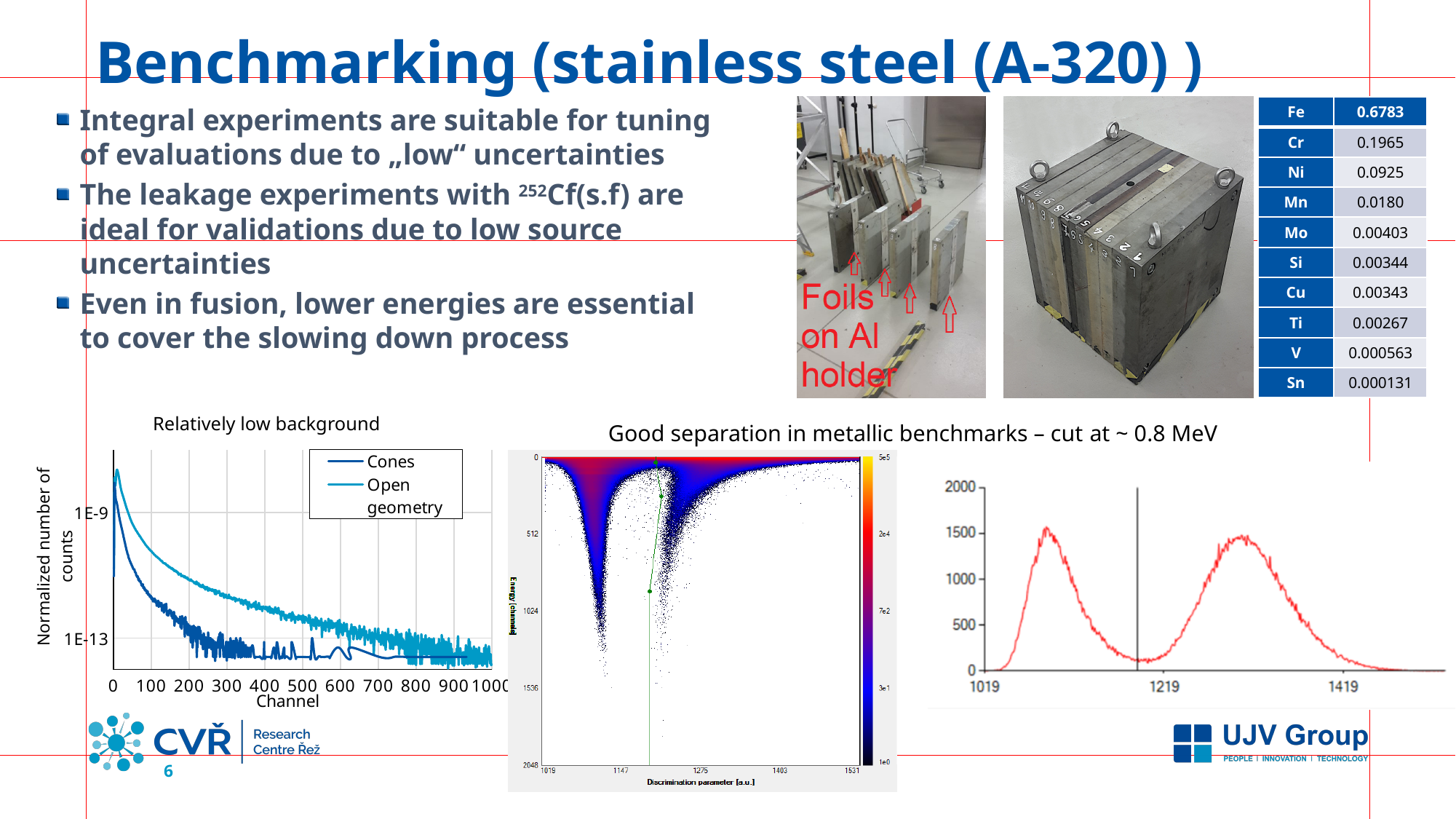
In the 'Relatively low background' chart, is the peak value of the Open geometry series greater or less than 1E-9? greater In the 'Relatively low background' chart, do the values of the Cones series rise or fall as the channel increases? fall What kind of chart is the 'Relatively low background' chart? line chart In the red histogram at the bottom right of the slide, is the height of the left peak greater or less than 1000? greater In the 'Relatively low background' chart, is the value of the Cones series at channel 100 greater or less than 1E-13? greater In the red histogram at the bottom right of the slide, how many peaks are visible? 2 What are the two series named in the legend of the 'Relatively low background' chart? Cones and Open geometry In the 'Relatively low background' chart, do the values of the Open geometry series rise or fall as the channel increases? fall How many series does the legend of the 'Relatively low background' chart list? 2 In the 'Relatively low background' chart, which series has the higher value at channel 500, Cones or Open geometry? Open geometry What is the x-axis label of the 'Relatively low background' chart? Channel